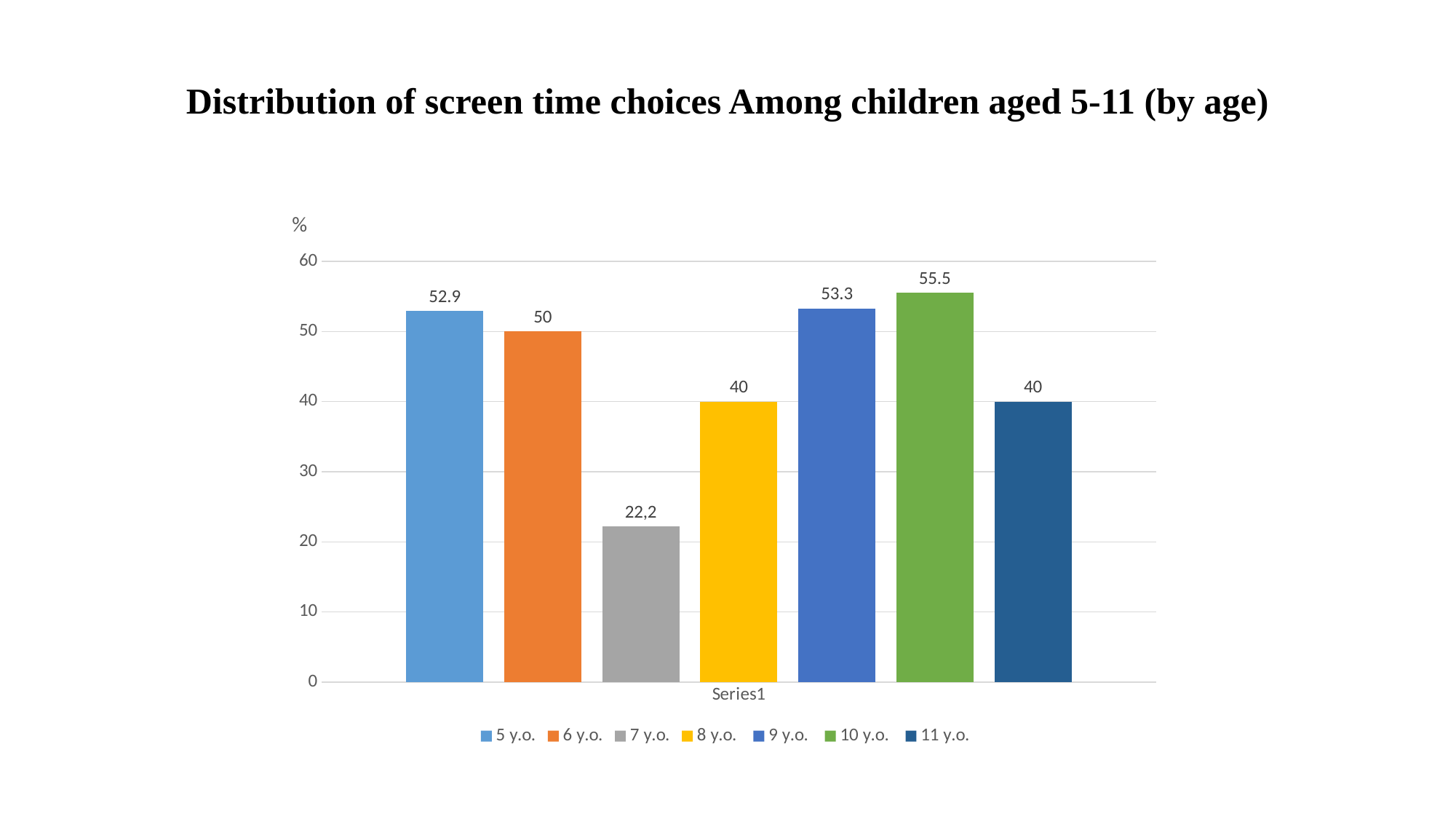
What is the value for 5 y.o.? 52.9 How many series does the legend list? 7 What is the difference between the values for 10 y.o. and 9 y.o.? 2.2 Which age group has the highest value? 10 y.o. What is the value for 7 y.o.? 22,2 What is the value for 10 y.o.? 55.5 Which age group has the lowest value? 7 y.o. What is the title of the chart? Distribution of screen time choices Among children aged 5-11 (by age) What is the value for 6 y.o.? 50 What kind of chart is shown on the slide? bar chart Which is larger, the value for 6 y.o. or the value for 8 y.o.? 6 y.o. Is the value for 7 y.o. greater or less than 30? less